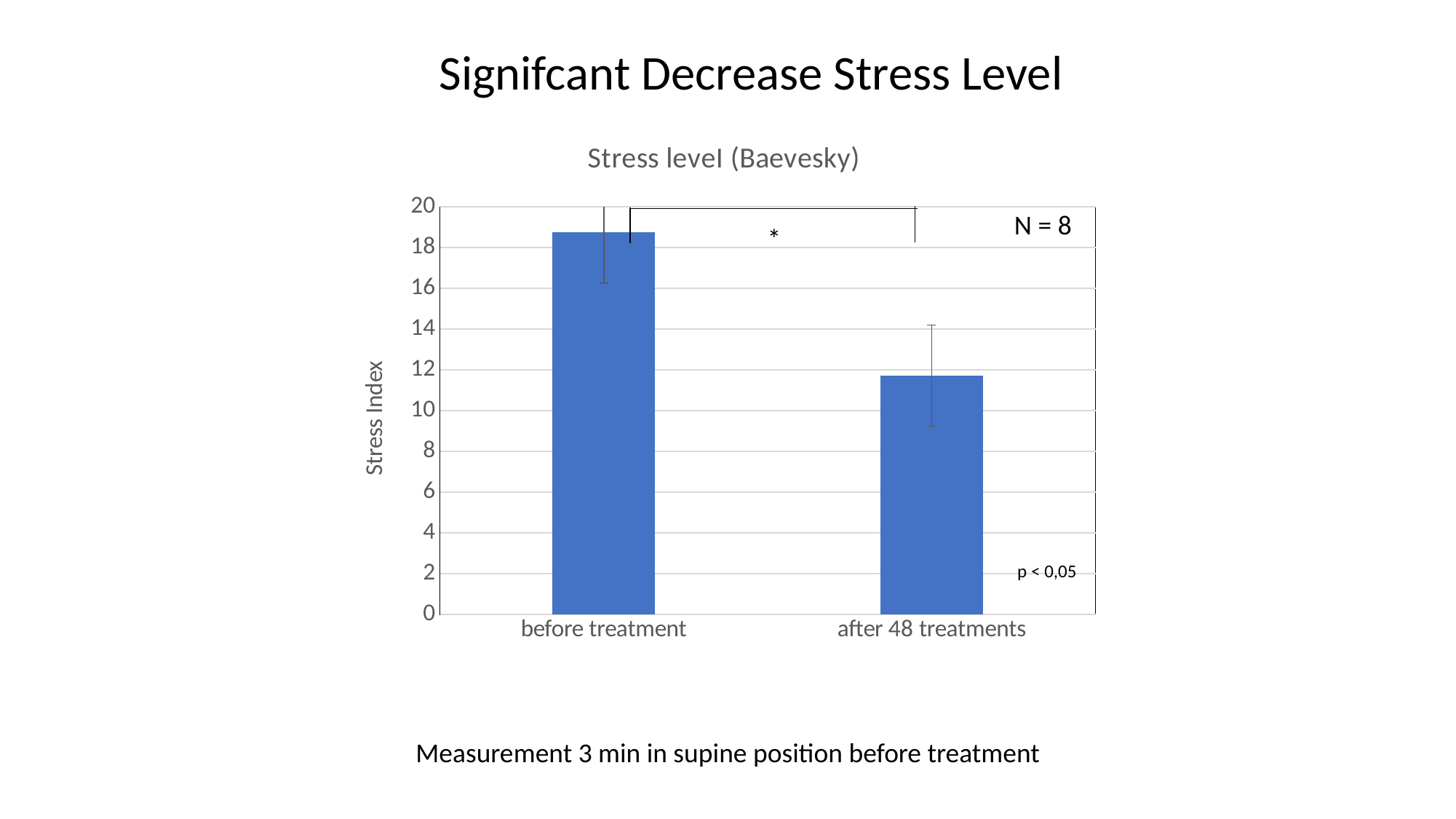
Do the values rise or fall from before treatment to after 48 treatments? fall What is the label of the vertical axis? Stress Index Is the value for after 48 treatments greater or less than 14? less How many categories are plotted on the x axis? 2 Which category has the lowest stress index? after 48 treatments Which category has the highest stress index? before treatment Is the value for before treatment greater or less than 16? greater Is the value for after 48 treatments greater or less than 10? greater Which is larger, the stress index before treatment or after 48 treatments? before treatment What is the title of the chart? Stress level (Baevesky) What type of chart is shown on the slide? bar chart What is the maximum value shown on the vertical axis? 20